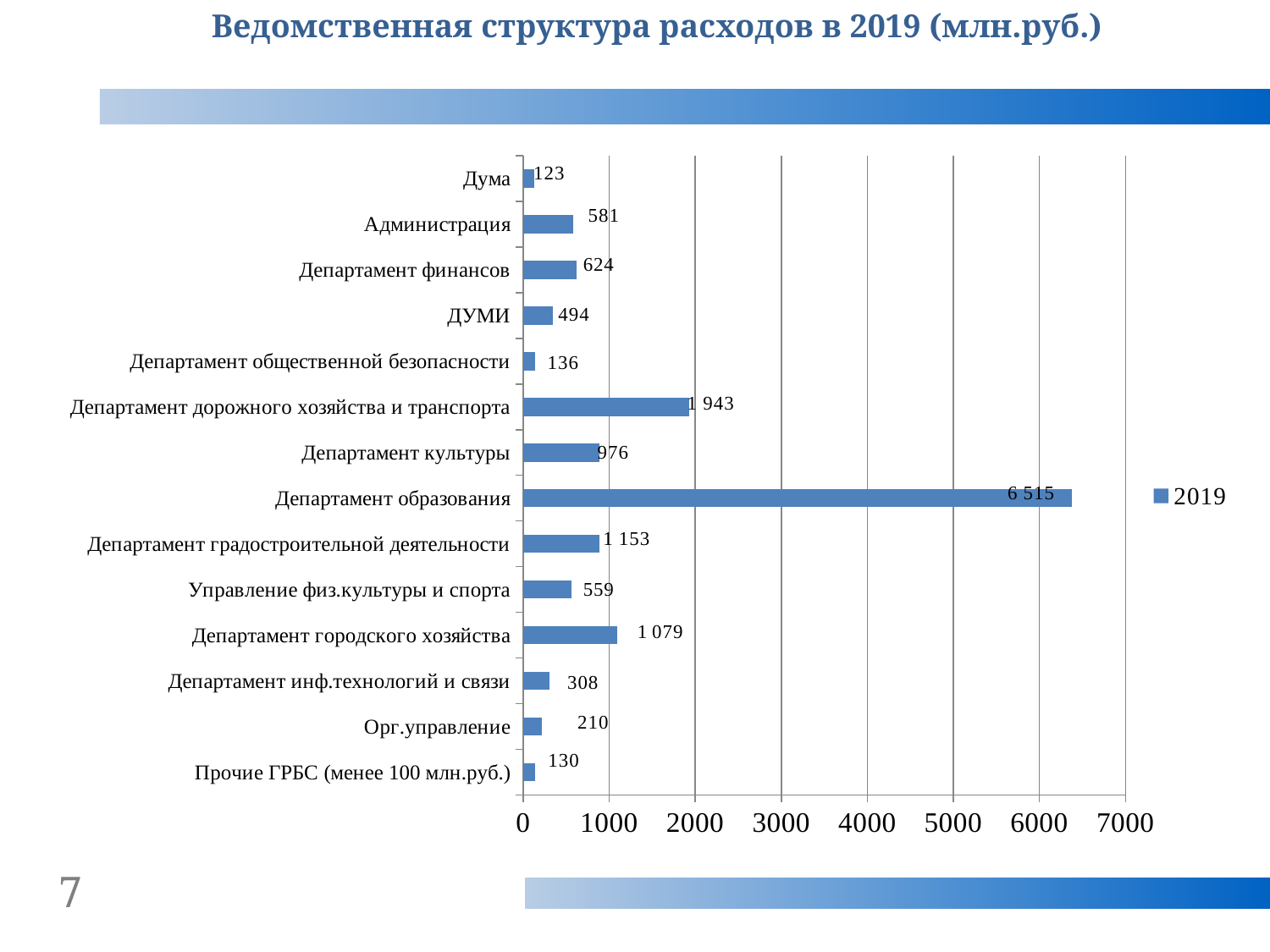
What is the difference between the values for Департамент финансов and Администрация? 43 What is the value for Орг.управление? 210 Is the value for Департамент культуры greater or less than 1000? less What is the value for Департамент дорожного хозяйства и транспорта? 1 943 What kind of chart is shown on the slide? bar chart What entry does the legend list? 2019 What is the value for Департамент образования? 6 515 What is the difference between the values for Департамент образования and Департамент дорожного хозяйства и транспорта? 4 572 Which category has the lowest value? Дума Which category has the highest value? Департамент образования How many categories are shown in the chart? 14